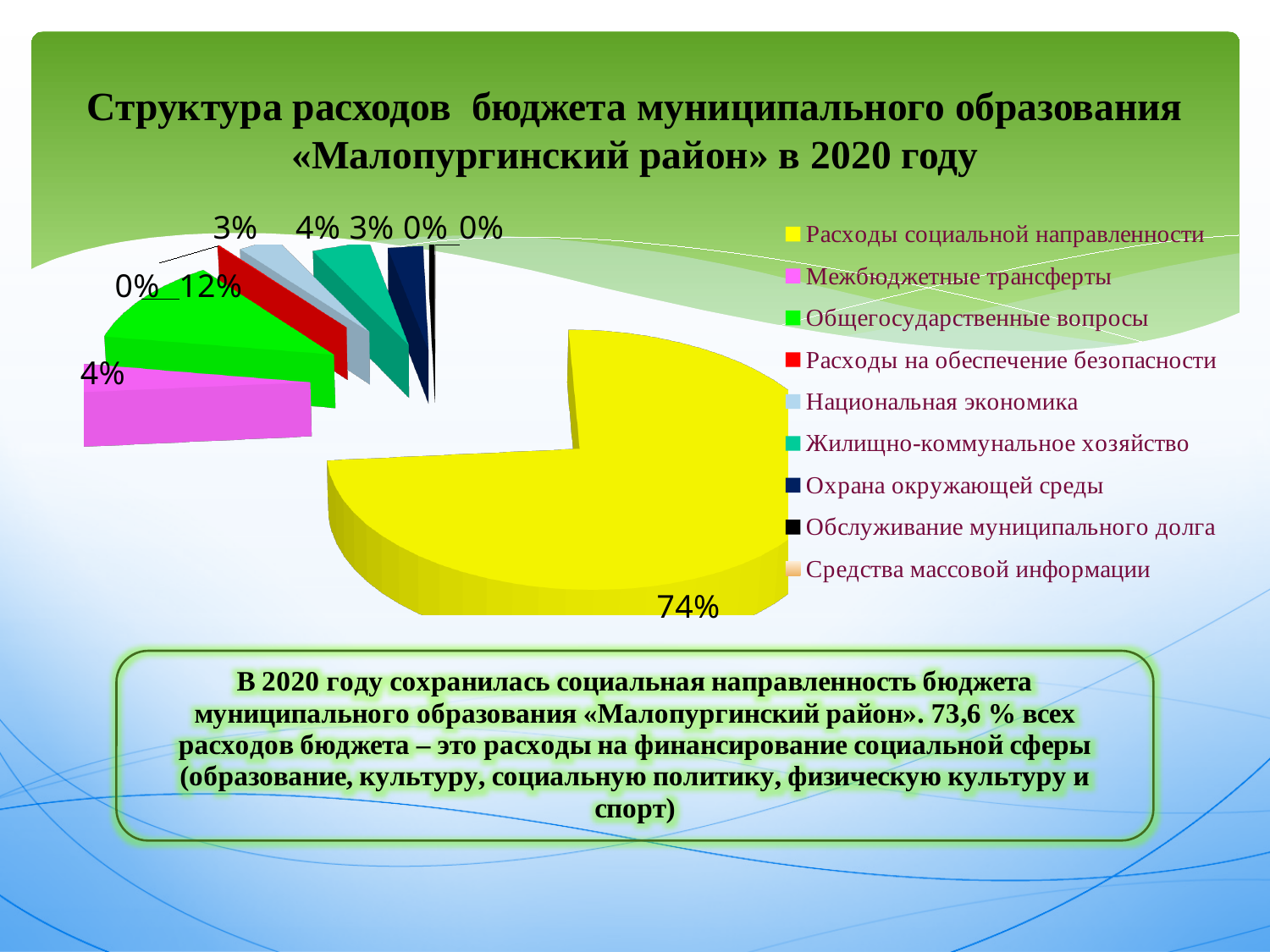
What percentage is shown for «Межбюджетные трансферты»? 4% What type of chart is shown on the slide? Pie chart Which is larger: «Общегосударственные вопросы» or «Межбюджетные трансферты»? Общегосударственные вопросы Which category has the largest slice of the pie? Расходы социальной направленности What colour is the largest slice of the pie? Yellow What is the title of the chart on the slide? Структура расходов бюджета муниципального образования «Малопургинский район» в 2020 году What percentage is shown for «Общегосударственные вопросы»? 12% How many categories does the legend of the pie chart list? 9 What percentage is shown for «Охрана окружающей среды»? 3% What percentage is shown for «Расходы на обеспечение безопасности»? 0% By how many percentage points does «Расходы социальной направленности» exceed «Общегосударственные вопросы»? 62 percentage points What share of the budget expenditures is labelled for «Расходы социальной направленности»? 74%